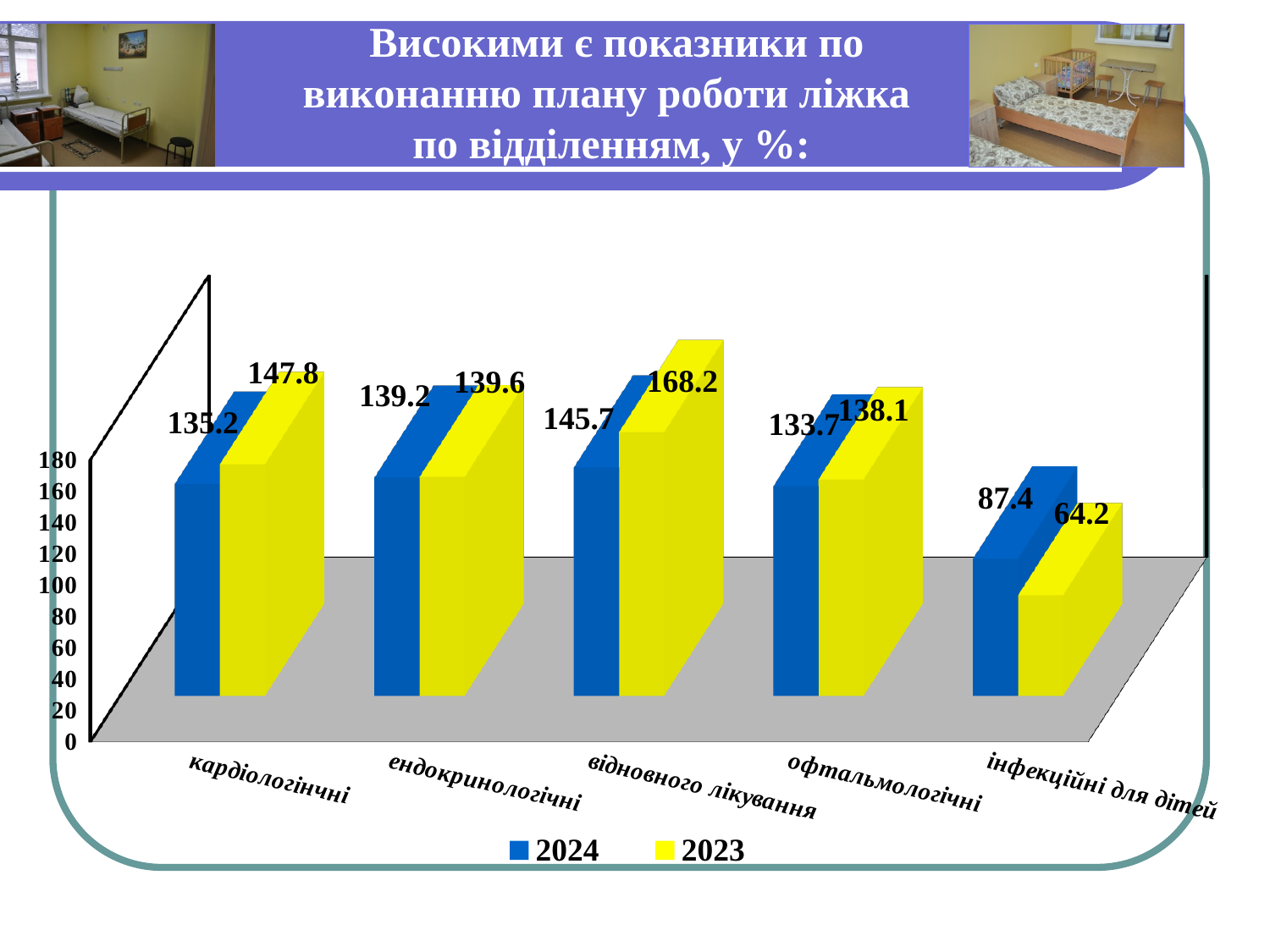
What is the difference between the 2023 and 2024 values for відновного лікування? 22.5 What is the value for кардіологінчні in the 2024 series? 135.2 How many series does the legend list? 2 Which category has the highest value in the 2023 series? відновного лікування What is the value for офтальмологічні in the 2023 series? 138.1 What is the difference between the 2024 and 2023 values for інфекційні для дітей? 23.2 For кардіологінчні, which series has the larger value, 2024 or 2023? 2023 What kind of chart is shown on the slide? bar chart Which category has the lowest value in the 2024 series? інфекційні для дітей How many categories are shown on the x axis? 5 What is the value for інфекційні для дітей in the 2024 series? 87.4 What is the value for відновного лікування in the 2023 series? 168.2